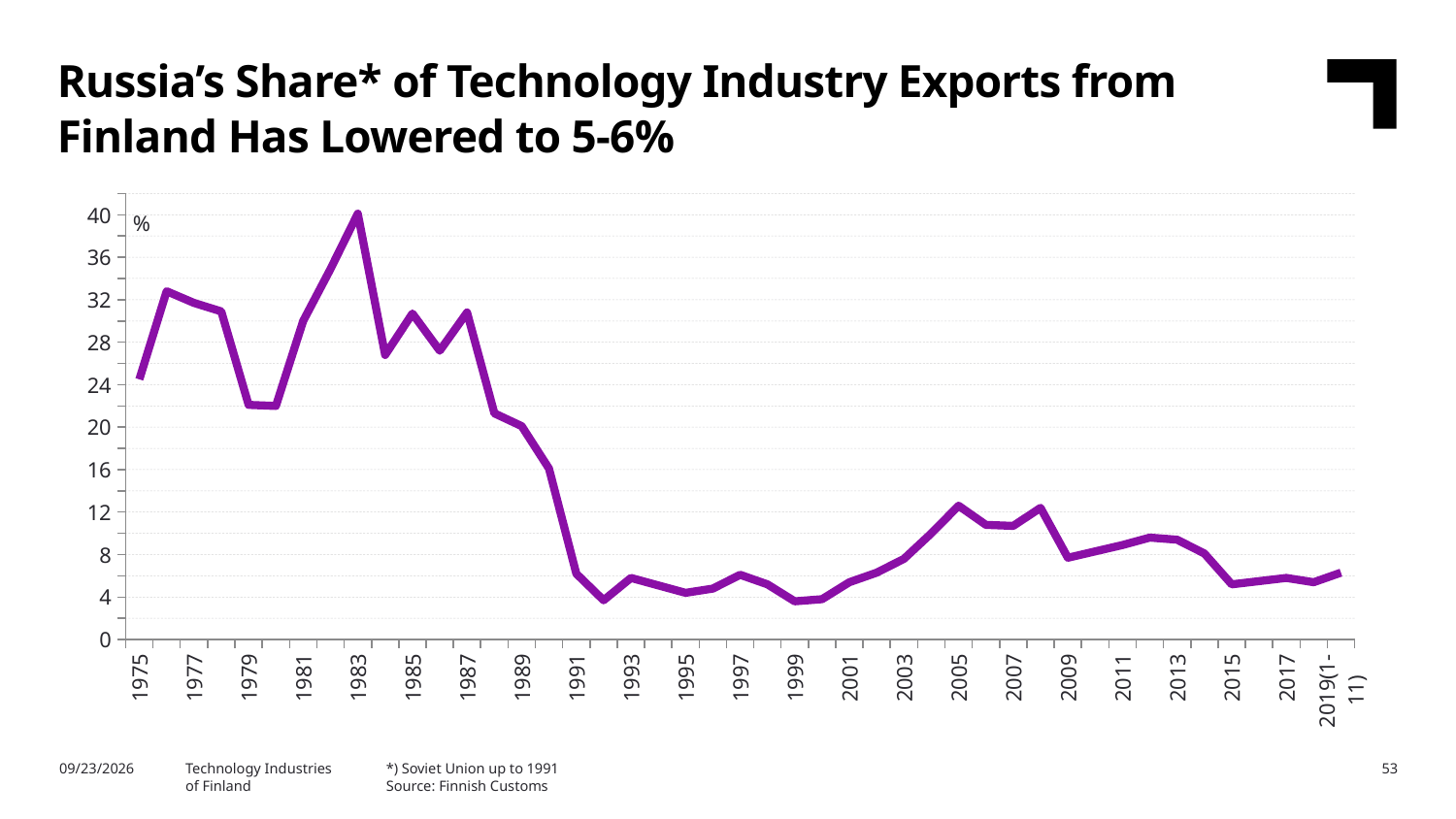
Which year has the larger value, 1983 or 2005? 1983 Is the value for 1975 greater or less than 20? greater Is the value for 2019(1-11) greater or less than 8? less What unit is shown on the vertical axis of the chart? % What kind of chart is shown on the slide? line chart According to the footnote, which country's figures are used up to 1991? Soviet Union Is the value for 1991 greater or less than 8? less In which year does Russia's share of technology industry exports from Finland reach its highest value? 1983 Overall, does Russia's share rise or fall from 1975 to 2019(1-11)? fall